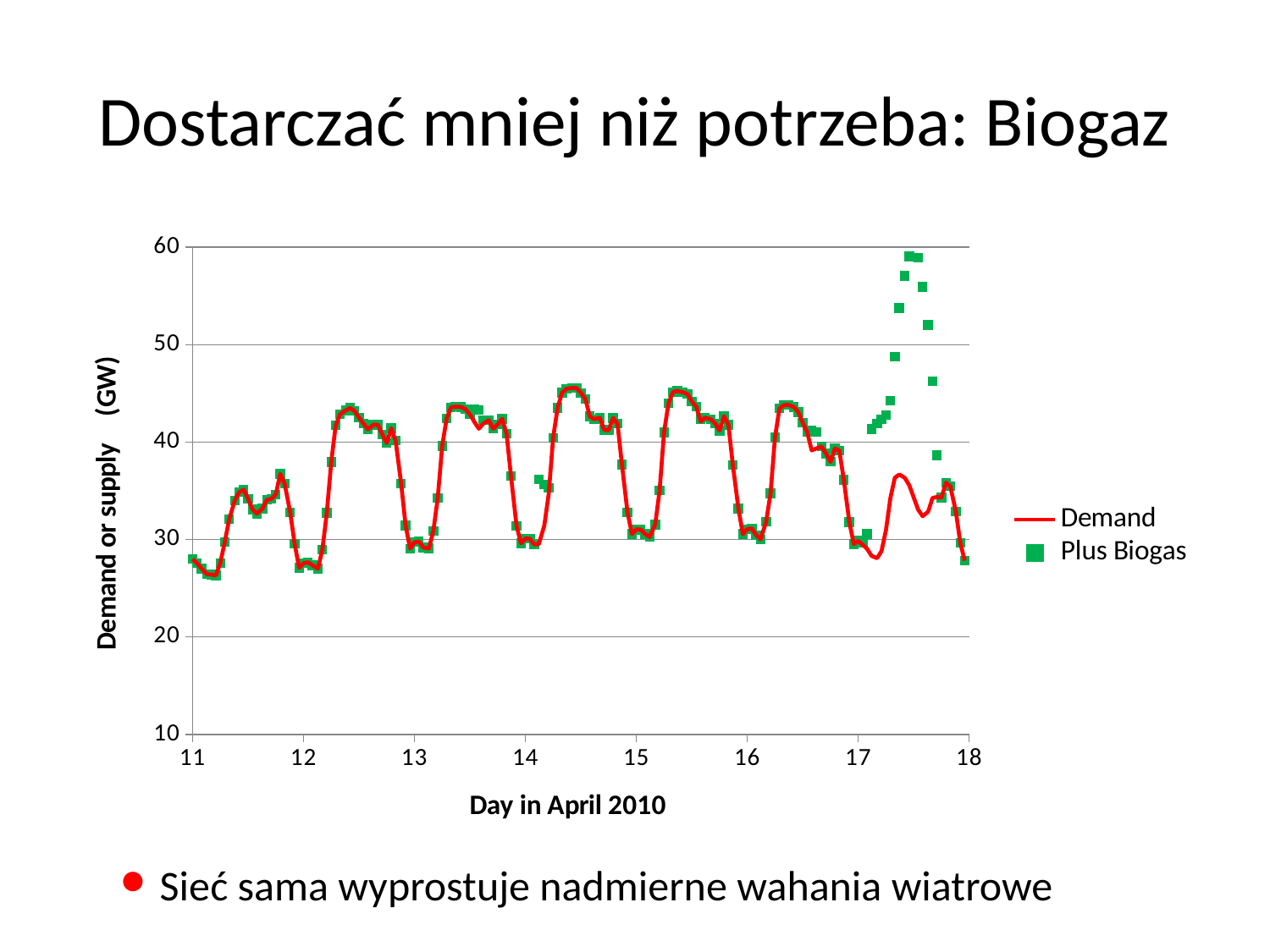
What kind of chart is shown on the slide? line chart Is the highest Plus Biogas value (around day 17.5) greater or less than 50? greater Does the Demand series ever exceed 50 GW? No Is the Demand value at day 18 greater or less than 30? less Which series reaches the higher maximum value, Demand or Plus Biogas? Plus Biogas How many series does the legend list? 2 What is the range of the y axis? 10 to 60 What is the title of the x axis? Day in April 2010 What are the names of the two series in the legend? Demand and Plus Biogas